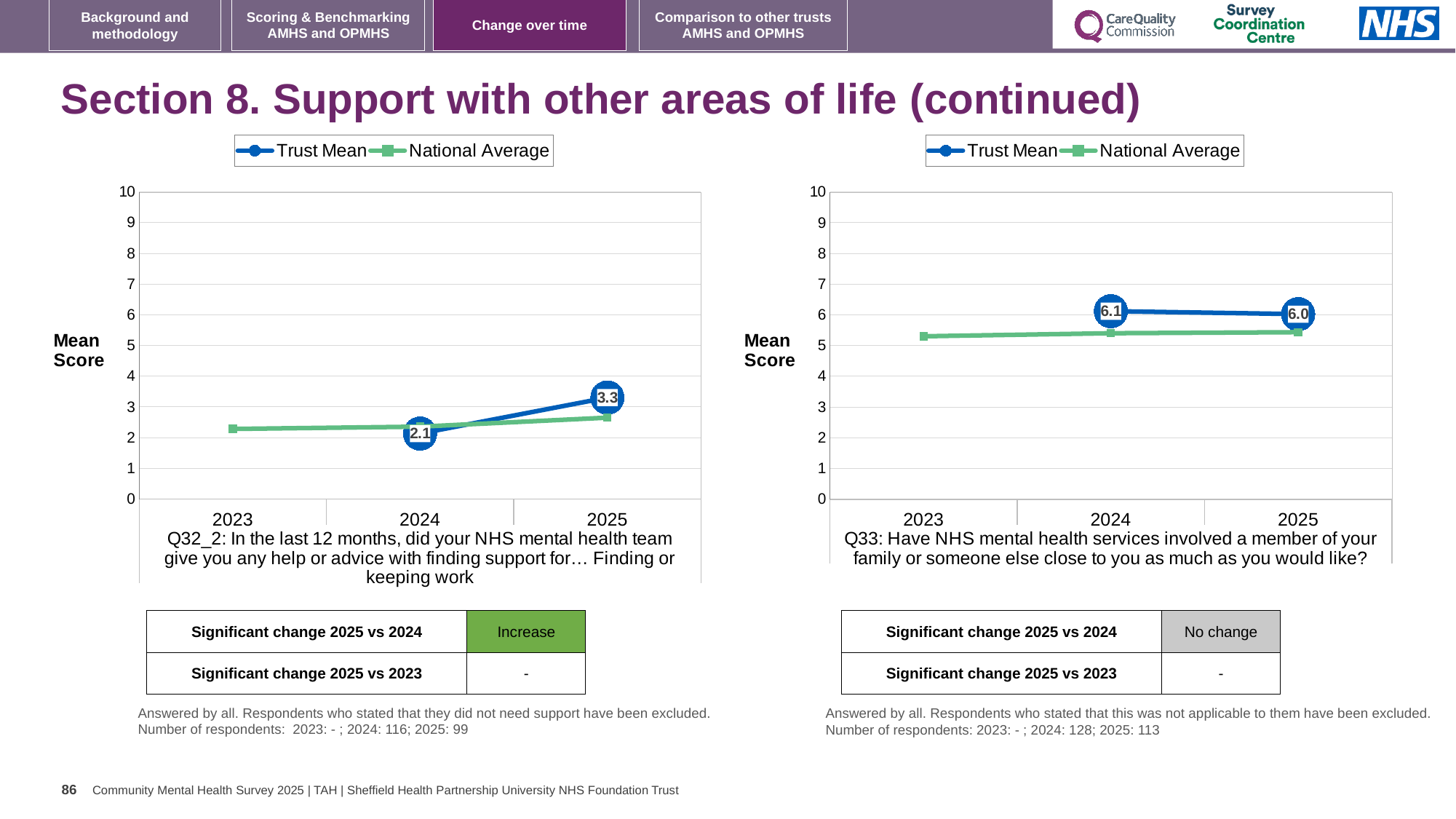
In the left chart (Q32_2), did the Trust Mean rise or fall from 2024 to 2025? rise How many series does the legend of the right chart (Q33) list? 2 In the left chart (Q32_2), what is the Trust Mean for 2025? 3.3 In the right chart (Q33), is the Trust Mean for 2025 greater or less than the Trust Mean for 2024? less In the left chart (Q32_2), what is the Trust Mean for 2024? 2.1 What type of chart is used for Q33 on the right of the slide? Line chart In the left chart (Q32_2), by how much did the Trust Mean change from 2024 to 2025? 1.2 In the right chart (Q33), what is the Trust Mean for 2024? 6.1 In the right chart (Q33), is the National Average for 2023 greater or less than 6? less In the left chart (Q32_2), is the National Average for 2025 greater or less than 3? less In the right chart (Q33), what is the Trust Mean for 2025? 6.0 How many years are shown on the x axis of the left chart (Q32_2)? 3